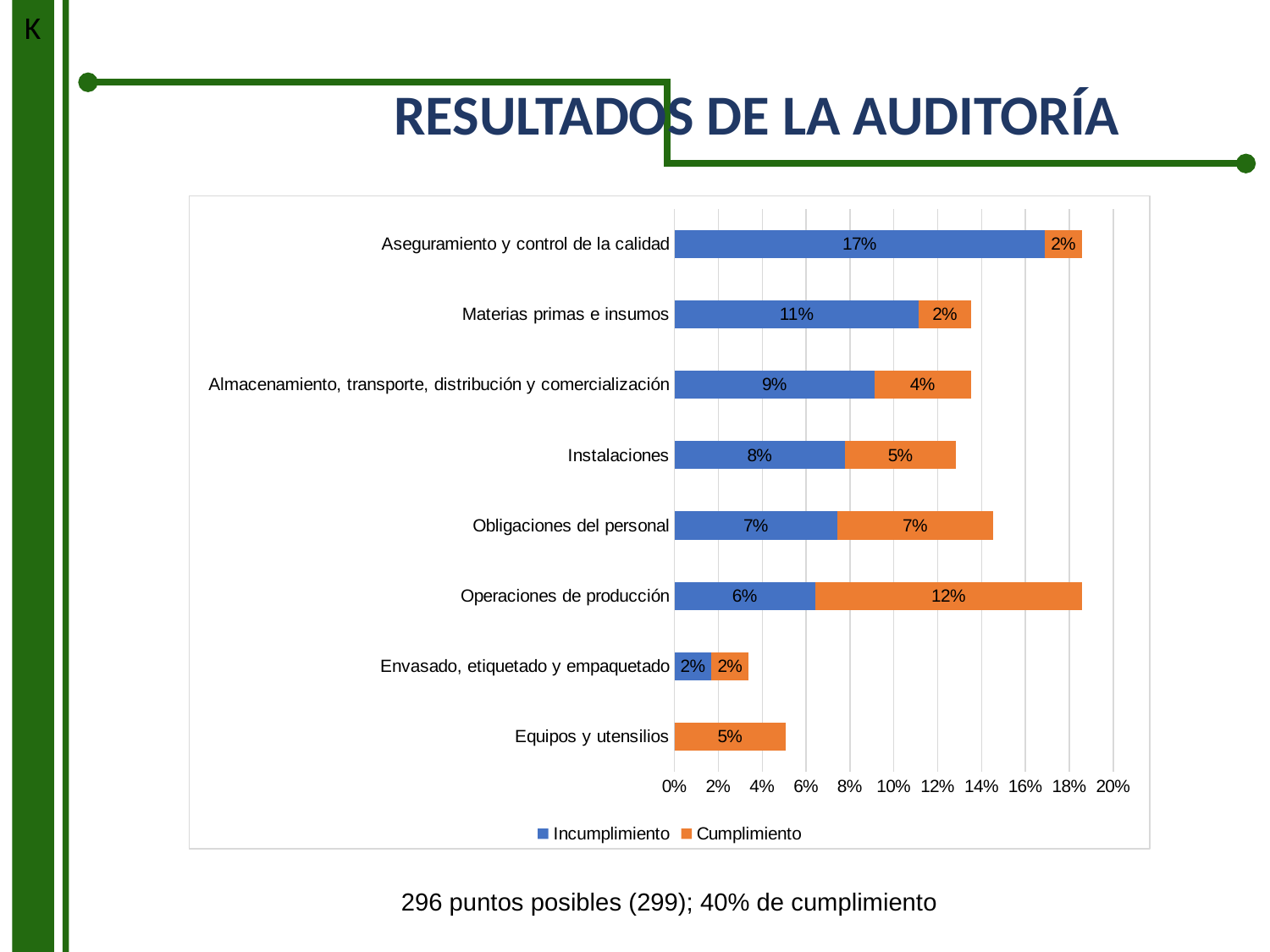
What type of chart is shown on the slide? Stacked bar chart What is the Cumplimiento value for Instalaciones? 5% What is the Cumplimiento value for Operaciones de producción? 12% What is the Incumplimiento value for Aseguramiento y control de la calidad? 17% Which colour represents the Cumplimiento series in the chart? Orange How many categories are plotted on the chart? 8 What is the difference between the Incumplimiento values for Aseguramiento y control de la calidad and Materias primas e insumos? 6 percentage points Which category has the highest Cumplimiento value? Operaciones de producción How many series does the chart legend list? 2 Which category has the highest Incumplimiento value? Aseguramiento y control de la calidad For Operaciones de producción, which is larger: Incumplimiento or Cumplimiento? Cumplimiento